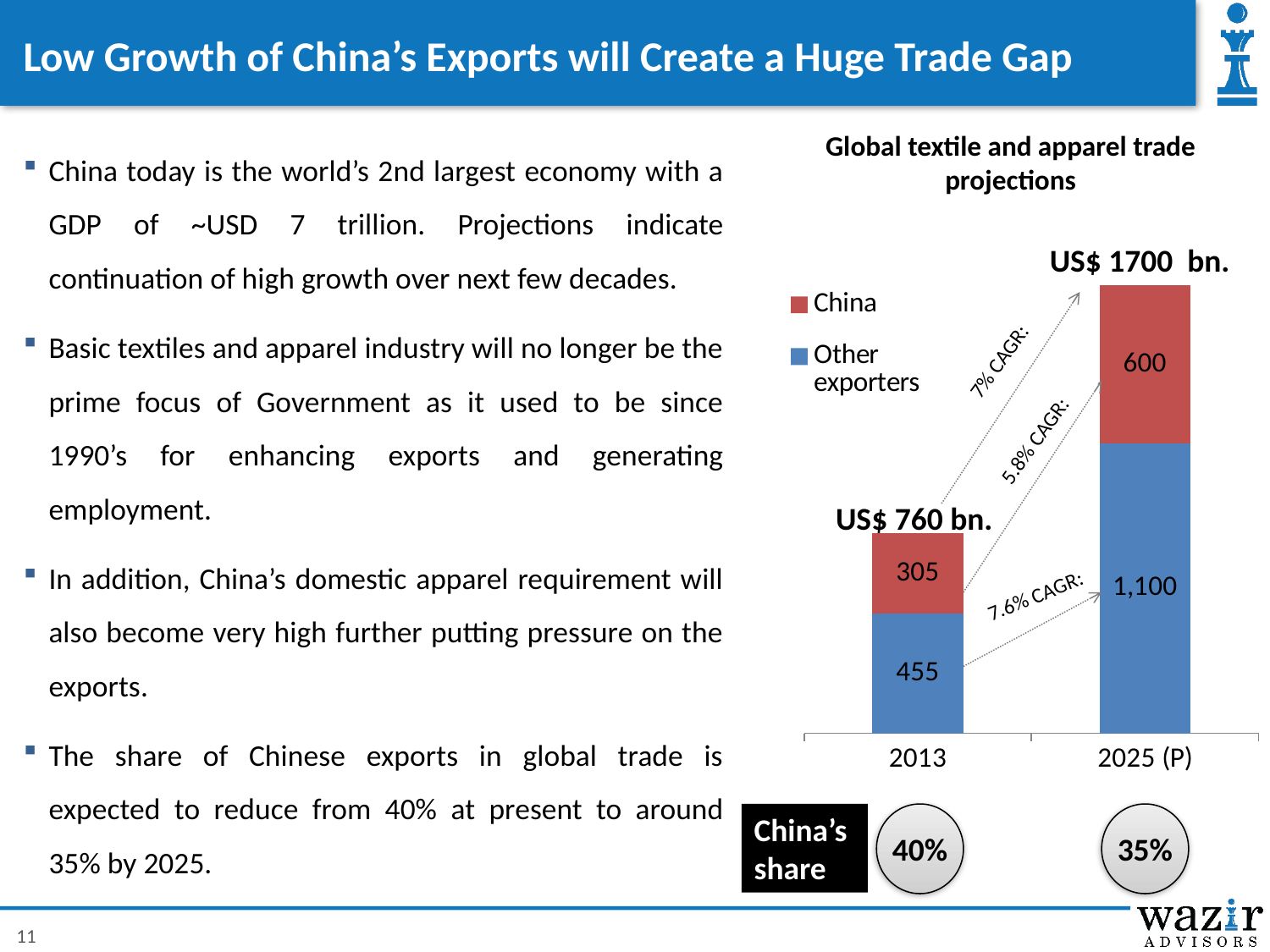
What is the value for China in 2013? 305 What is the difference between the China values for 2025 (P) and 2013? 295 Which is larger in 2013, the value for China or the value for Other exporters? Other exporters What is the value for Other exporters in 2013? 455 What is the value for China in 2025 (P)? 600 How many series does the legend list? 2 What is the total of the stacked bar for 2013 as labelled on the chart? US$ 760 bn. What is the title of the chart? Global textile and apparel trade projections How many categories are shown on the x axis? 2 What kind of chart is shown on the slide? Stacked bar chart What is the total of the stacked bar for 2025 (P) as labelled on the chart? US$ 1700 bn. What is the value for Other exporters in 2025 (P)? 1,100